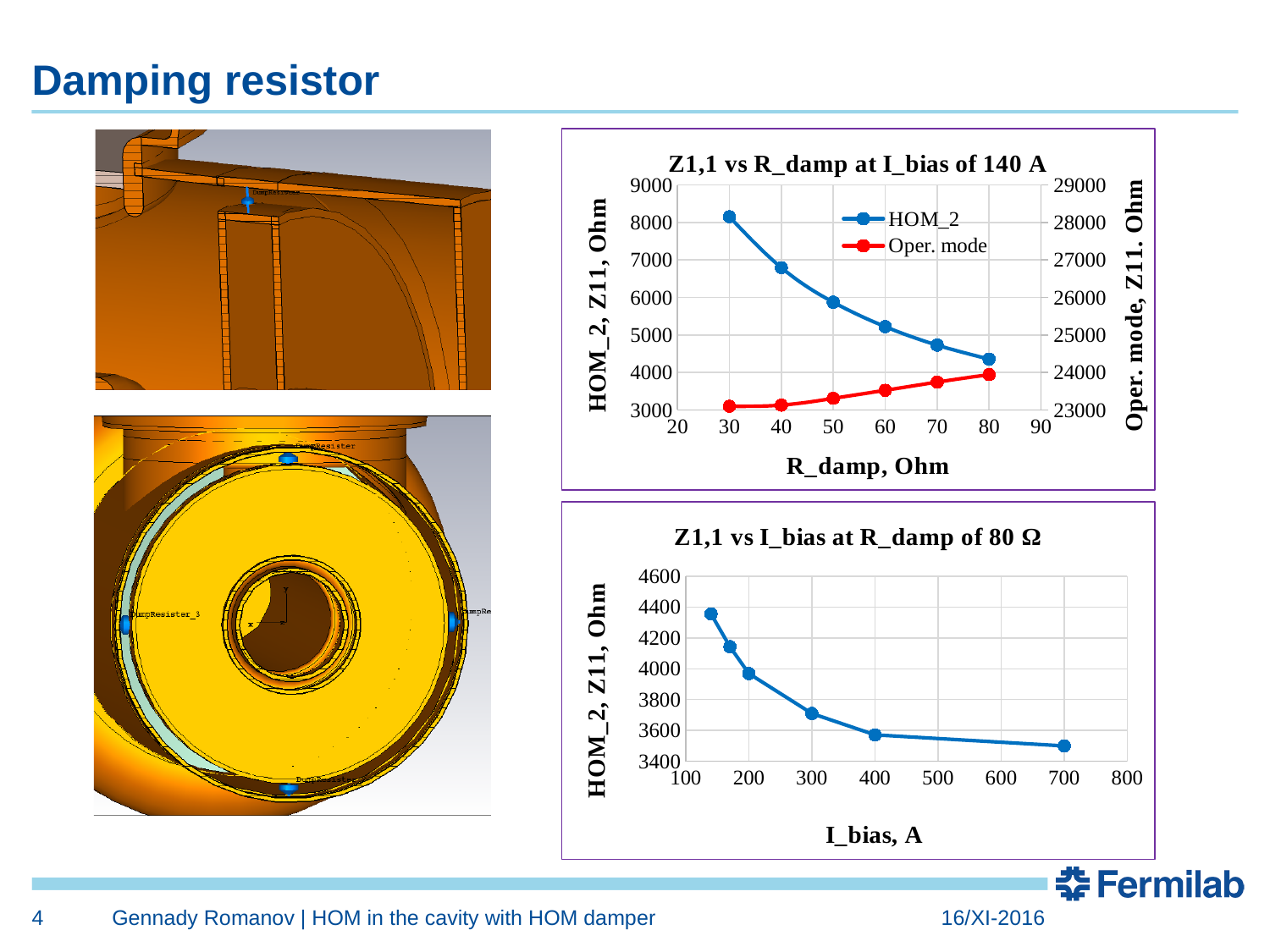
What kind of chart is the chart titled "Z1,1 vs I_bias at R_damp of 80 Ω"? line chart In the chart titled "Z1,1 vs I_bias at R_damp of 80 Ω", what is the x-axis title? I_bias, A In the chart titled "Z1,1 vs R_damp at I_bias of 140 A", is the Oper. mode value at R_damp of 30 Ohm greater or less than 24000? less In the chart titled "Z1,1 vs I_bias at R_damp of 80 Ω", is the value at I_bias of 700 A greater or less than 3600? less In the chart titled "Z1,1 vs R_damp at I_bias of 140 A", what are the names of the two series in the legend? HOM_2 and Oper. mode In the chart titled "Z1,1 vs R_damp at I_bias of 140 A", is the HOM_2 value at R_damp of 30 Ohm greater or less than 8000? greater In the chart titled "Z1,1 vs R_damp at I_bias of 140 A", does the Oper. mode series rise or fall as R_damp increases? rise In the chart titled "Z1,1 vs R_damp at I_bias of 140 A", how many series does the legend list? 2 In the chart titled "Z1,1 vs R_damp at I_bias of 140 A", does the HOM_2 series rise or fall as R_damp increases? fall In the chart titled "Z1,1 vs I_bias at R_damp of 80 Ω", does the value rise or fall as I_bias increases? fall In the chart titled "Z1,1 vs R_damp at I_bias of 140 A", how many data points does the HOM_2 series have? 6